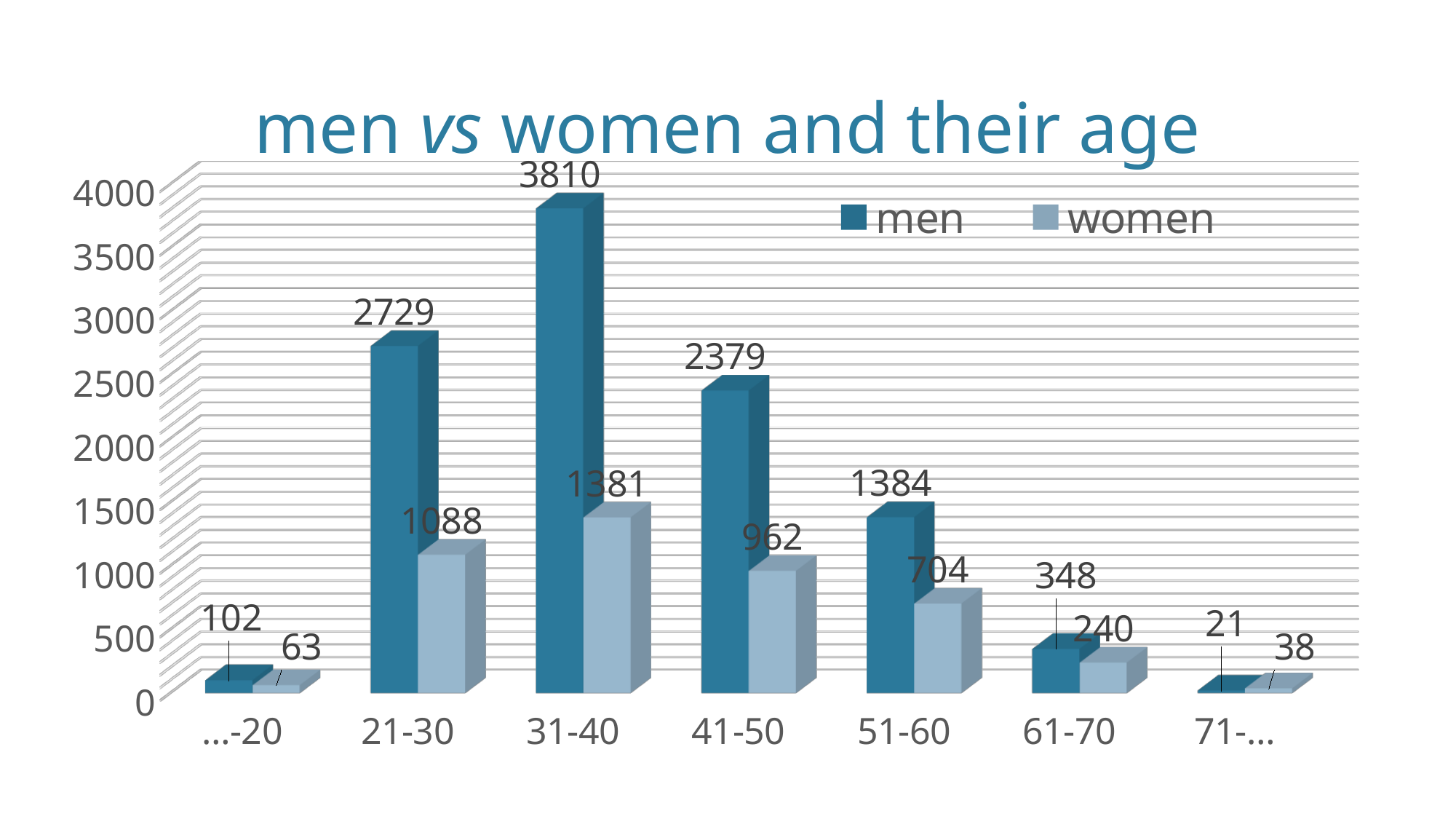
What is the title of the chart? men vs women and their age Which age group has the lowest value for women? 71-... How many age groups are shown on the x axis? 7 What is the difference between men and women in the 41-50 age group? 1417 What is the value for men in the 61-70 age group? 348 What is the value for women in the 21-30 age group? 1088 Which age group has the highest value for men? 31-40 How many series does the legend list? 2 Which is larger in the 71-... age group, men or women? women Do the values for women rise or fall from the 31-40 age group to the 71-... age group? fall What is the value for men in the 31-40 age group? 3810 What kind of chart is shown on the slide? bar chart